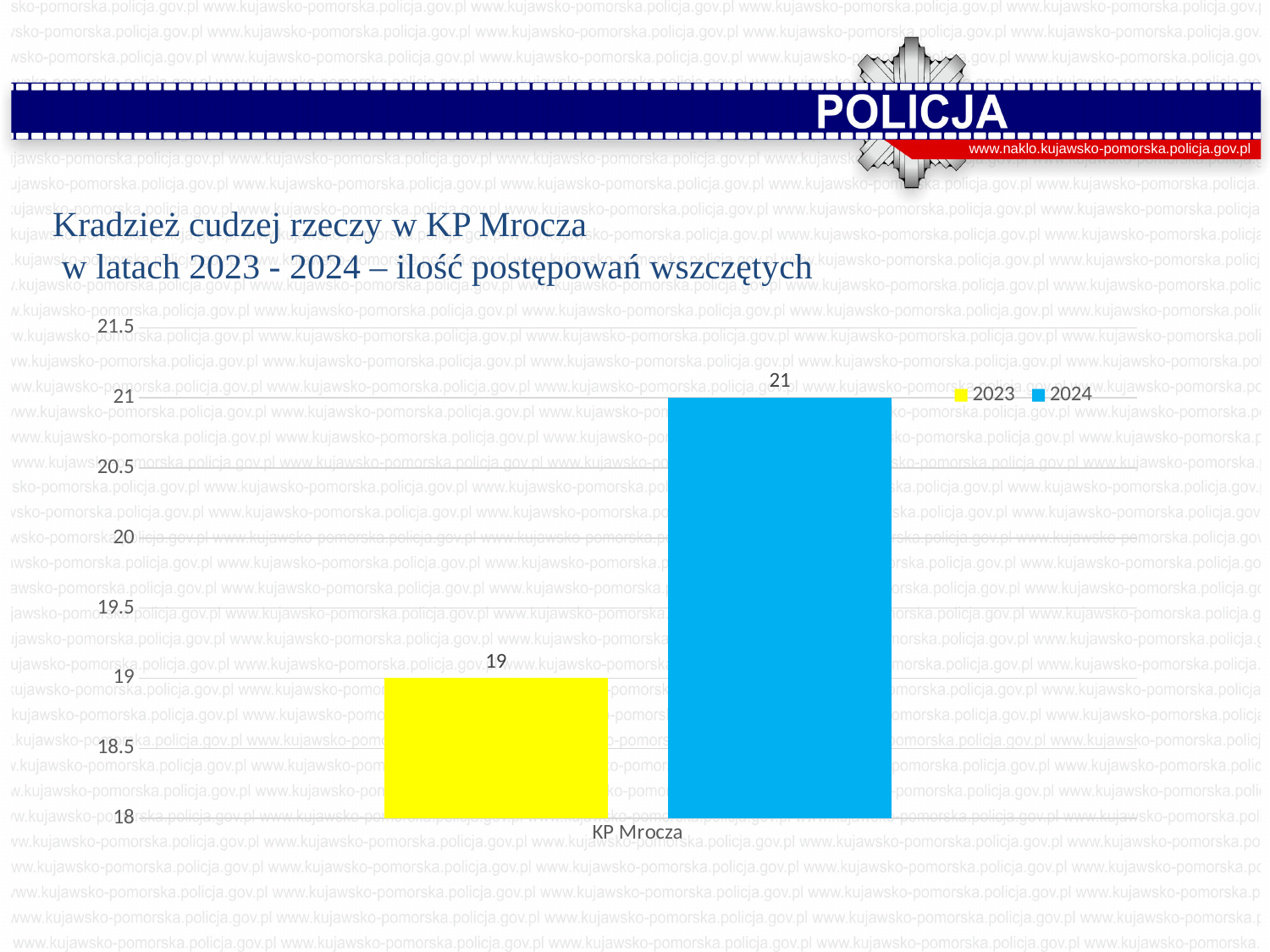
What is the category label on the x axis? KP Mrocza What is the value for 2023 in the chart? 19 What colour is the bar for 2024? blue What is the value for 2024 in the chart? 21 Is the value for 2023 greater or less than 20? less Which series has the lowest value in the chart? 2023 How many series does the legend list? 2 What is the difference between the 2024 and 2023 values? 2 What kind of chart is shown on the slide? bar chart Which year has the higher value, 2023 or 2024? 2024 Is the value for 2024 greater or less than 20? greater How many categories are shown on the x axis? 1